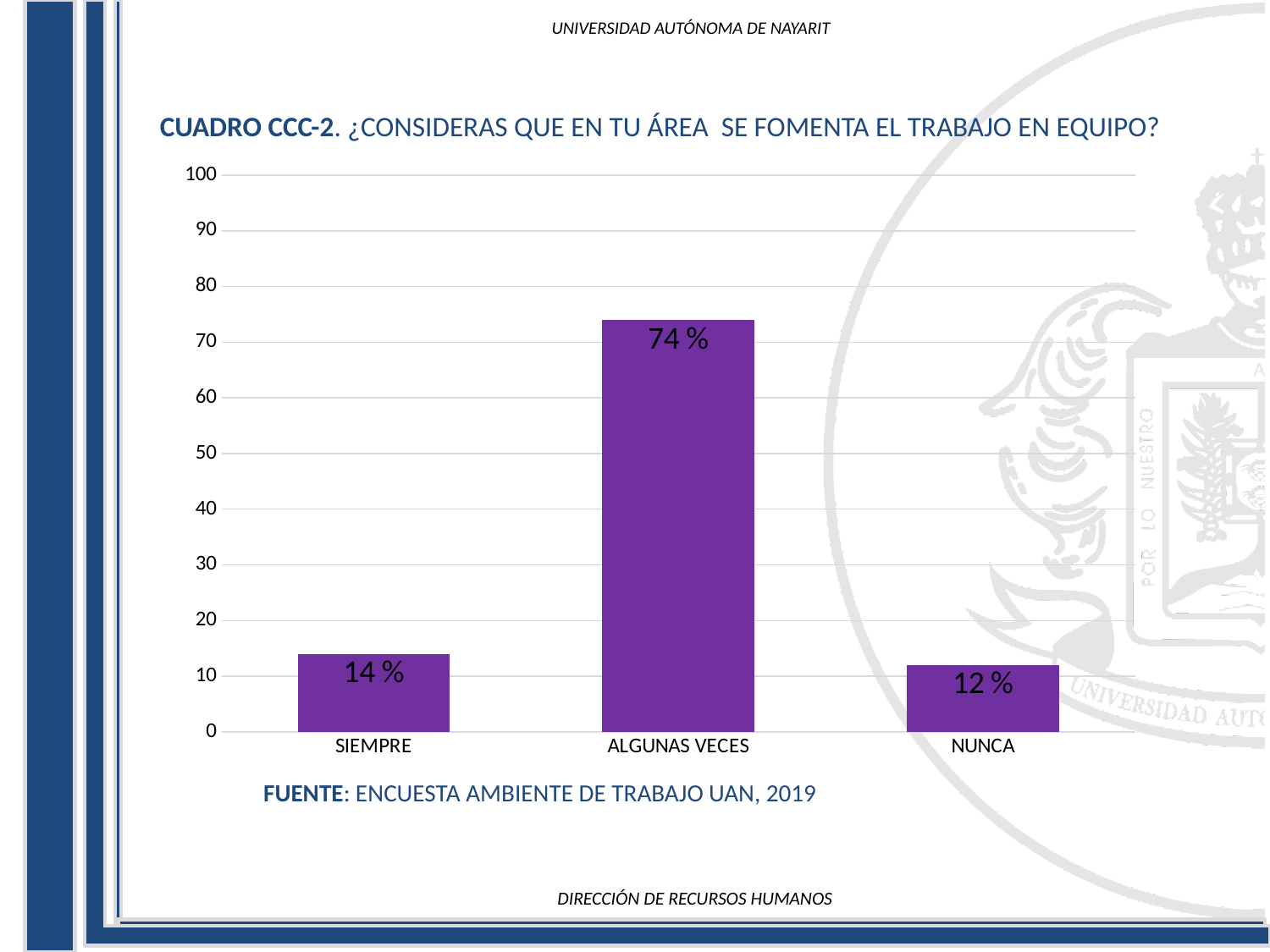
What kind of chart is shown on the slide? bar chart What is the value for SIEMPRE? 14 % What is the difference between the values for SIEMPRE and NUNCA? 2 % Which category has the highest value? ALGUNAS VECES What is the value for NUNCA? 12 % What source is cited below the chart? ENCUESTA AMBIENTE DE TRABAJO UAN, 2019 What is the difference between the values for ALGUNAS VECES and SIEMPRE? 60 % Which is larger, the value for SIEMPRE or the value for NUNCA? SIEMPRE What is the value for ALGUNAS VECES? 74 % Which category has the lowest value? NUNCA How many categories are shown on the x axis? 3 Is the value for ALGUNAS VECES greater or less than 50? greater